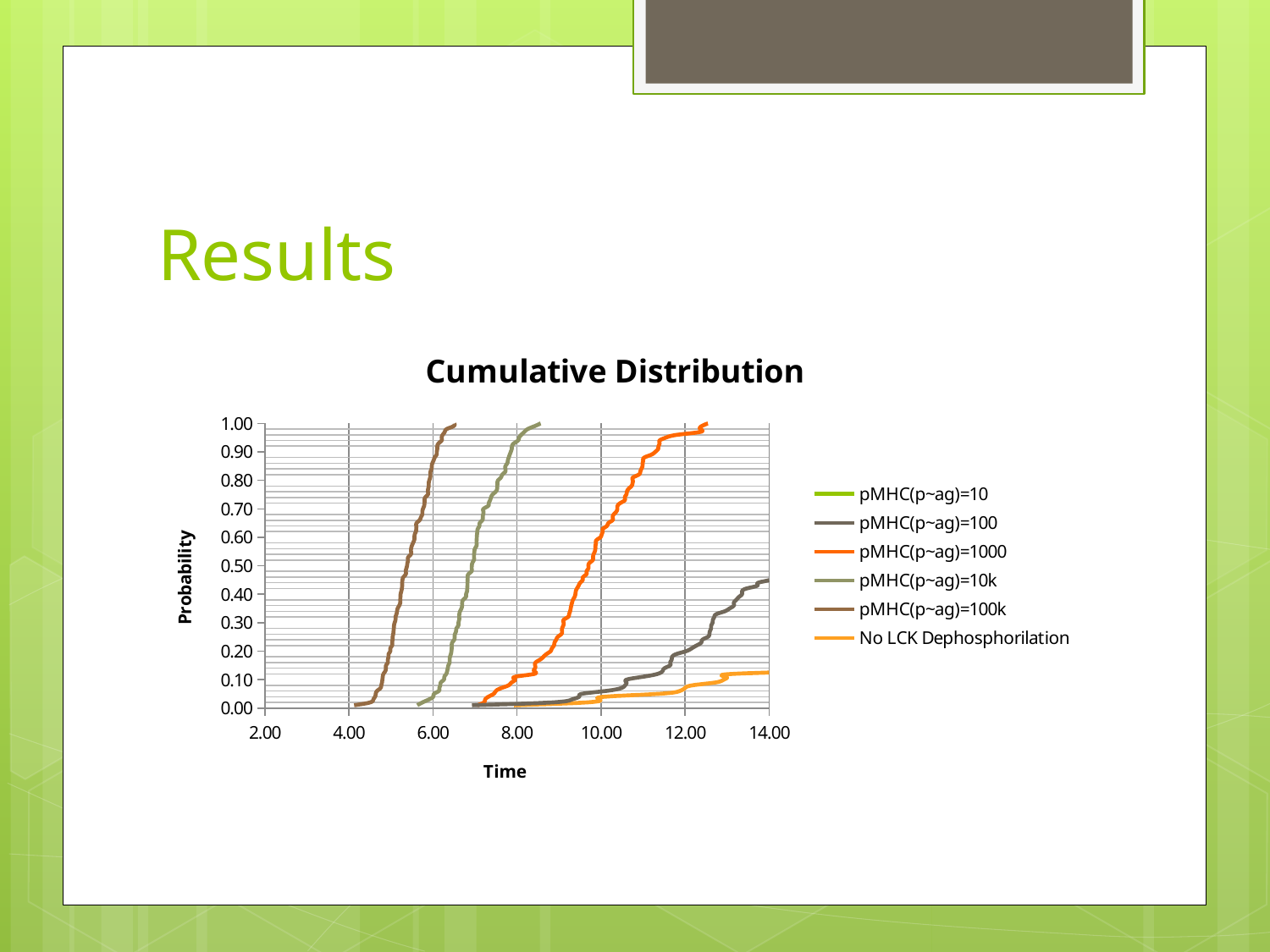
Is the value for pMHC(p~ag)=100 at Time 14.00 greater or less than 0.50? less Is the value for pMHC(p~ag)=1000 at Time 11.00 greater or less than 0.50? greater What kind of chart is shown on the slide? line chart How many series does the legend of the Cumulative Distribution chart list? 6 Which series reaches a probability of 1.00 at the smallest Time? pMHC(p~ag)=100k Do the values of the pMHC(p~ag)=1000 series rise or fall as Time increases? rise Is the value for pMHC(p~ag)=100 at Time 14.00 greater or less than 0.30? greater What is the title of the chart? Cumulative Distribution What is the label of the vertical axis of the chart? Probability At Time 14.00, which series has the higher probability: pMHC(p~ag)=100 or No LCK Dephosphorilation? pMHC(p~ag)=100